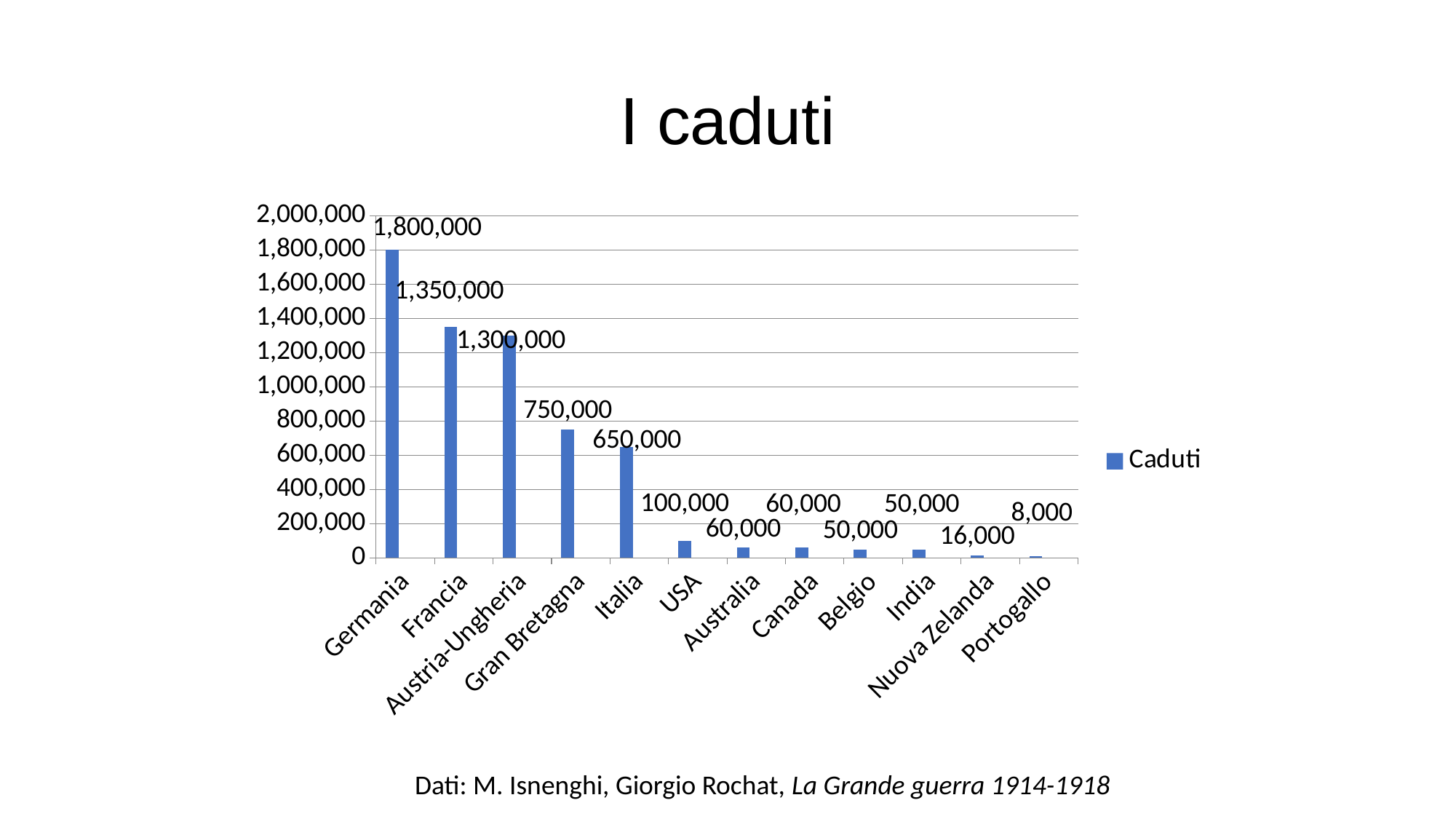
What is the difference between the values for Germania and Francia? 450,000 What is the name of the series shown in the legend? Caduti How many series does the legend list? 1 What is the value for Nuova Zelanda? 16,000 Which is larger, the value for Francia or the value for Austria-Ungheria? Francia Which country has the lowest value? Portogallo What is the difference between the values for Gran Bretagna and Italia? 100,000 How many countries are shown on the x axis? 12 What is the value for Italia? 650,000 What is the value for Germania? 1,800,000 Which country has the highest value? Germania What type of chart is shown on the slide? bar chart